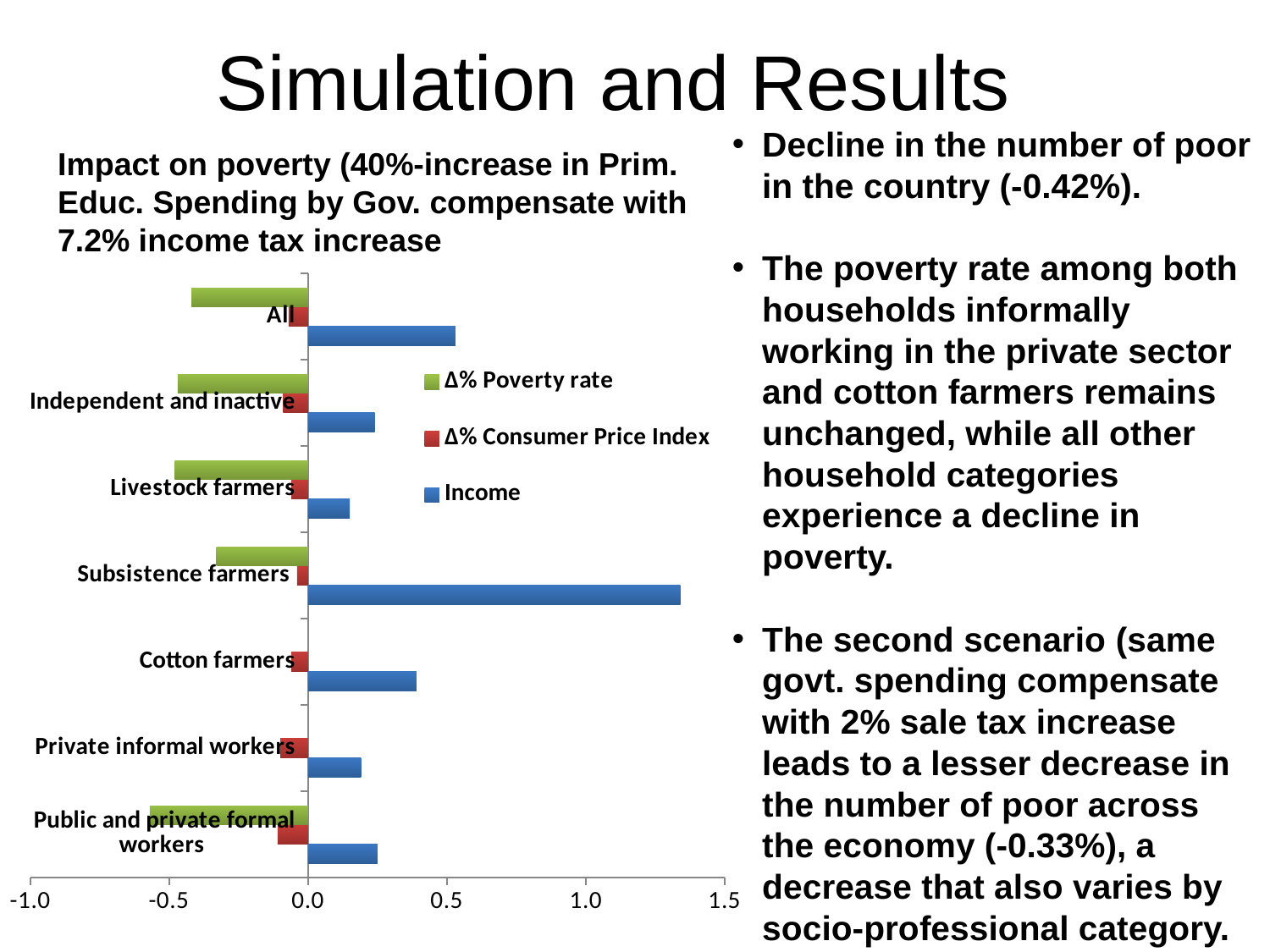
Is the Income value for Livestock farmers greater or less than 0.5? less Is the Income value for Subsistence farmers greater or less than 1.0? greater How many household categories are plotted on the chart? 7 Which category has the highest Income value? Subsistence farmers Is the Δ% Poverty rate value for Public and private formal workers greater or less than -0.5? less How many series does the chart's legend list? 3 Which is larger, the Income value for Independent and inactive or for Livestock farmers? Independent and inactive What colour represents the Income series in the chart? blue Which category has the lowest (most negative) Δ% Poverty rate value? Public and private formal workers Which is larger, the Income value for Subsistence farmers or for Cotton farmers? Subsistence farmers What kind of chart is shown on the slide? bar chart